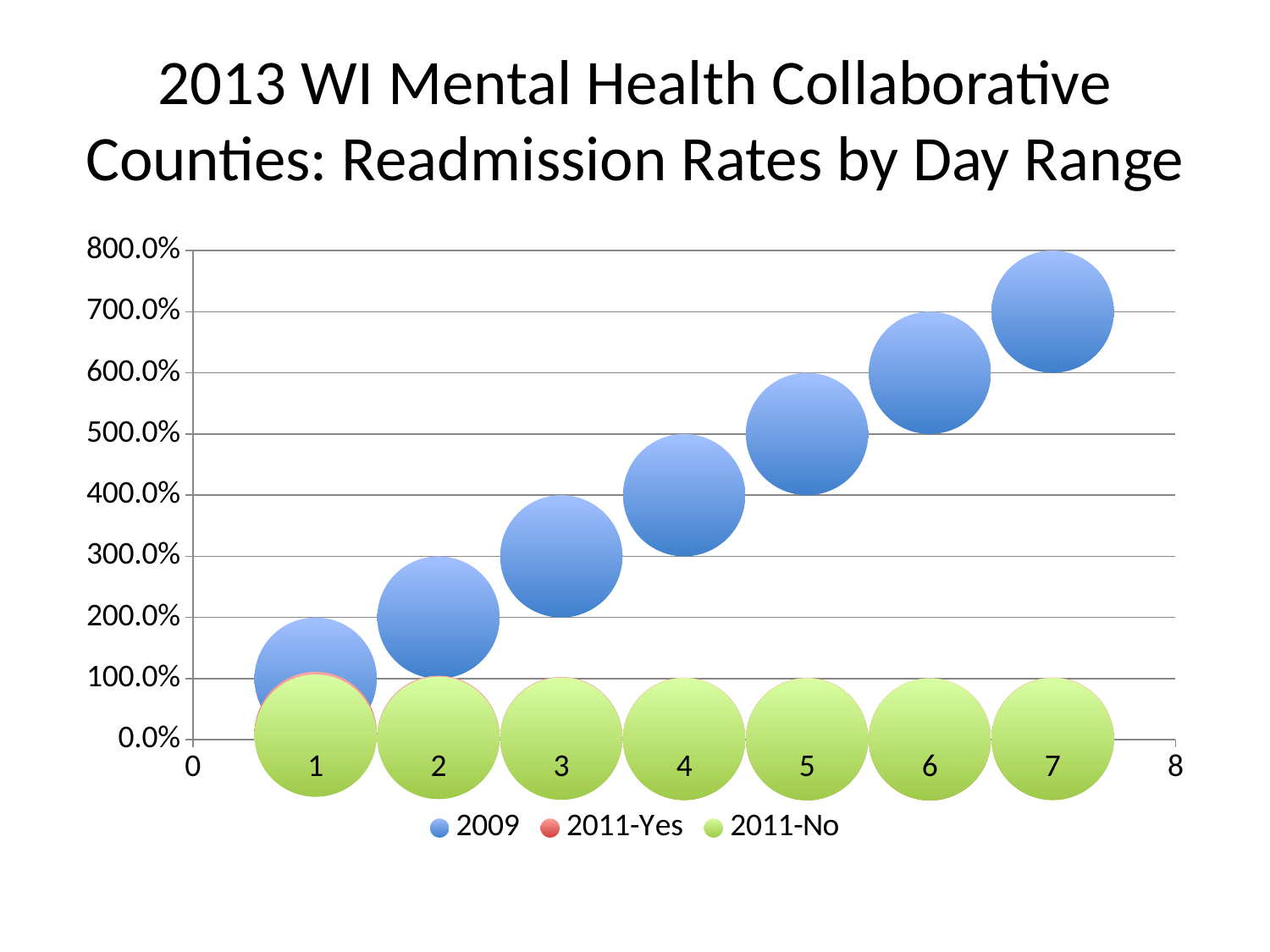
Which is larger for the 2009 series: the value at x = 5 or the value at x = 2? x = 5 Do the 2009 series values rise or fall as the x value increases from 1 to 7? rise At which x value is the 2009 series highest? 7 How many bubbles are plotted for the 2009 series? 7 How many series does the legend list? 3 Is the 2009 value at x = 2 greater or less than 300.0%? less Which series is shown in blue? 2009 At which x value is the 2009 series lowest? 1 Is the 2011-No value at x = 6 greater or less than 100.0%? less What are the three series named in the legend? 2009, 2011-Yes, 2011-No Is the 2009 value at x = 4 greater or less than 300.0%? greater What kind of chart is shown on the slide? bubble chart